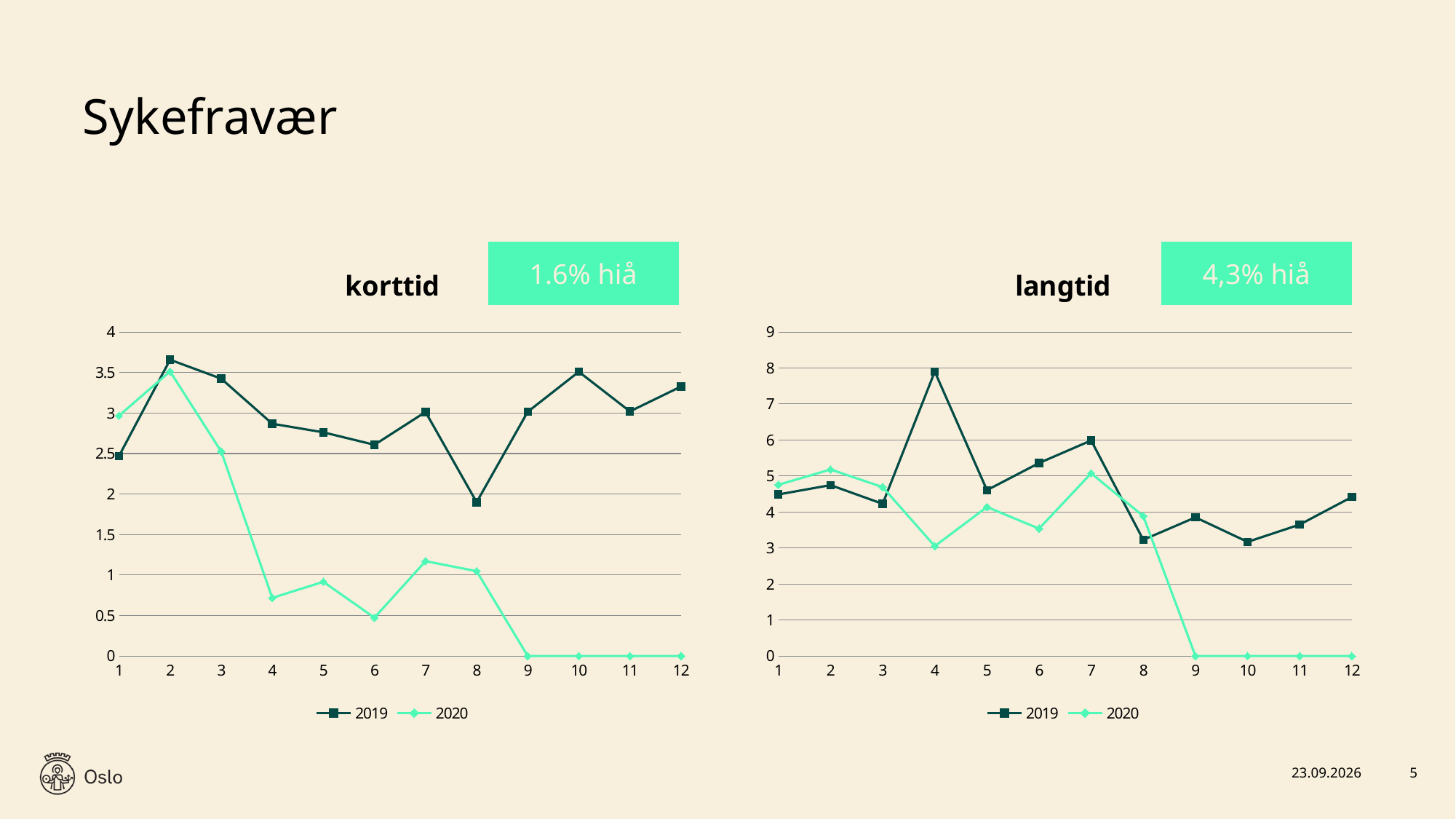
In the langtid chart, what is the value for 2020 at month 12? 0 In the langtid chart, is the 2019 value at month 4 greater or less than 7? greater How many points are plotted along the x axis of the korttid chart for each series? 12 In the langtid chart, at which month is the 2019 value highest? 4 In the korttid chart, what is the value for 2020 at month 9? 0 In the korttid chart, at which month is the 2020 value highest? 2 What value is shown in the green box next to the langtid chart title? 4,3% hiå In the korttid chart, at which month is the 2019 value lowest? 8 In the langtid chart, which series has the larger value at month 2, 2019 or 2020? 2020 In the korttid chart, is the 2019 value at month 1 greater or less than 3? less What kind of chart is the korttid chart? line chart How many series does the legend of the langtid chart list? 2